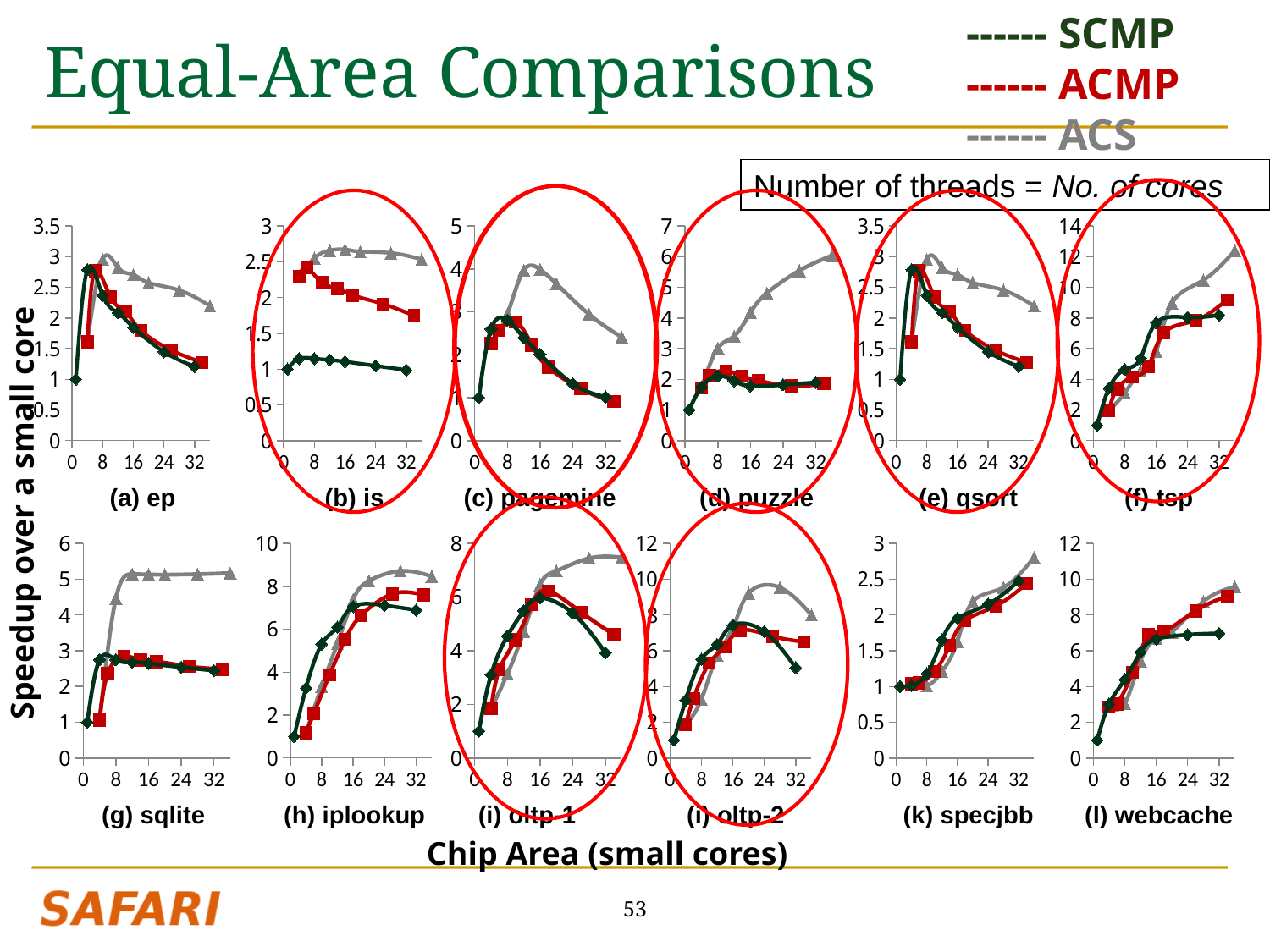
In the (k) specjbb chart, do the series generally rise or fall as chip area increases? rise In the (b) is chart, is the ACS value at chip area 32 greater or less than 2? greater In the (b) is chart, at chip area 8, which series is higher, SCMP or ACMP? ACMP How many benchmark panels (charts) are shown on the slide? 12 In the (g) sqlite chart, is the ACS value at chip area 32 greater or less than 4? greater In the (c) pagemine chart, is the SCMP value at chip area 32 greater or less than 2? less What is the shared y-axis label printed to the left of the charts? Speedup over a small core What kind of chart is used for each of the twelve panels on the slide? line chart How many series does the legend at the top right list? 3 In the (d) puzzle chart, at chip area 32, which series is higher, ACS or ACMP? ACS What is the shared x-axis label printed below the charts? Chip Area (small cores)